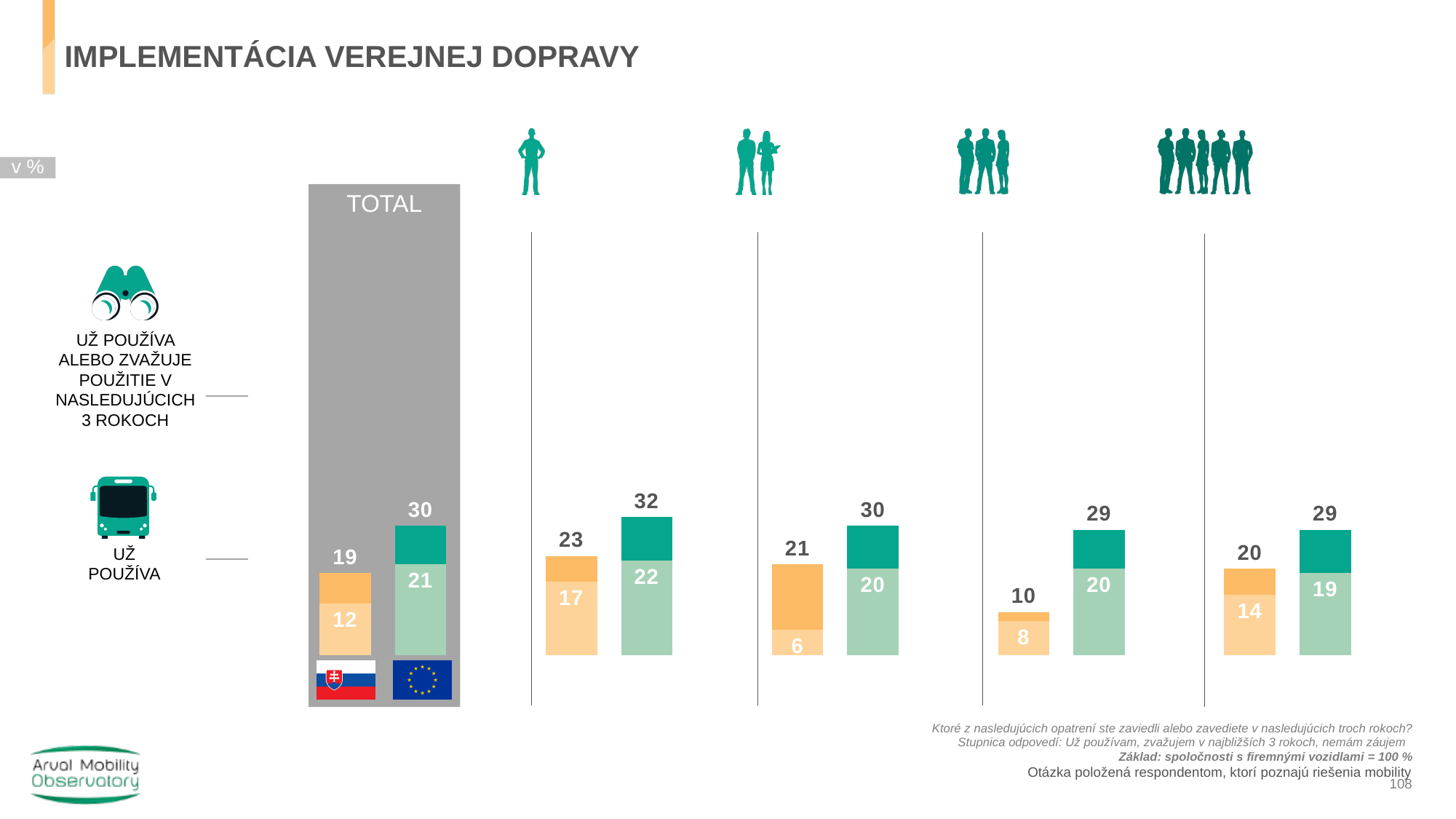
In the first group to the right of the TOTAL section, what is the difference between the EU value (32) and the Slovakia value (23)? 9 Across all groups on the slide, what is the highest value shown on a green (EU) bar? 32 In the TOTAL section, what is the value for Slovakia (the bar with the Slovak flag) for 'už používa alebo zvažuje použitie v nasledujúcich 3 rokoch'? 19 In the TOTAL section, what is the value for the EU (the bar with the EU flag) for 'už používa alebo zvažuje použitie v nasledujúcich 3 rokoch'? 30 How many groups of bars are shown on the slide, including the TOTAL group? 5 What kind of chart is shown on the slide? bar chart In the TOTAL section, which is larger: the Slovakia bar or the EU bar? EU In the TOTAL section, what is the 'už používa' value for the EU? 21 In the TOTAL section, what is the difference between the EU value (30) and the Slovakia value (19)? 11 In the TOTAL section, what is the 'už používa' value for Slovakia? 12 In what unit are the values on the slide expressed, according to the label at the top left? v %